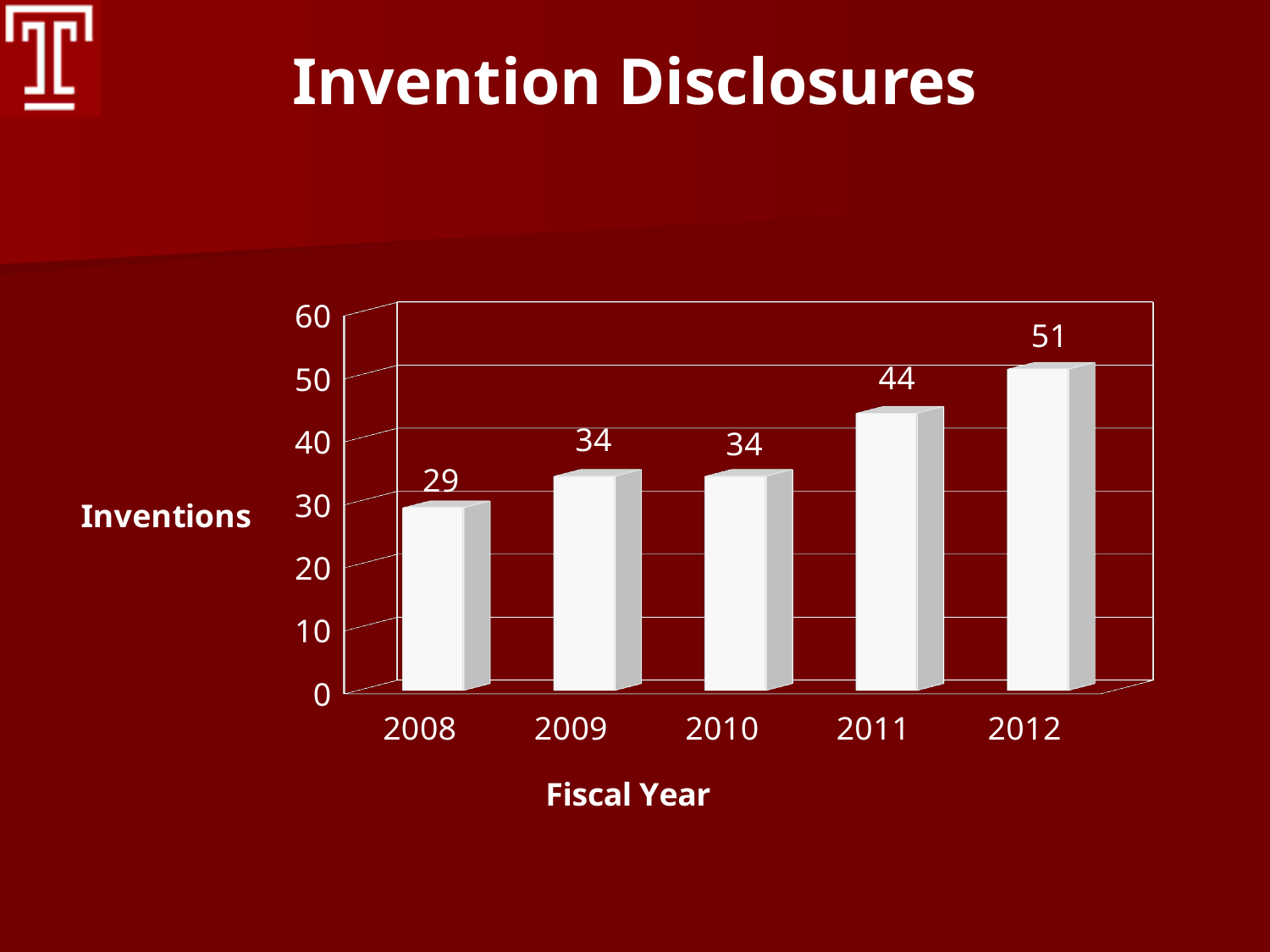
What kind of chart is shown on the slide? Bar chart What is the number of inventions for fiscal year 2012? 51 What is the number of inventions for fiscal year 2011? 44 Which fiscal year has the highest number of inventions? 2012 What is the difference in inventions between fiscal year 2012 and fiscal year 2008? 22 Which fiscal year has the lowest number of inventions? 2008 What is the difference in inventions between fiscal year 2011 and fiscal year 2010? 10 How many fiscal years are shown on the x axis? 5 What is the title of the chart? Invention Disclosures What is the number of inventions for fiscal year 2008? 29 Is the value for fiscal year 2012 greater or less than 50? greater Which fiscal year has more inventions, 2009 or 2011? 2011